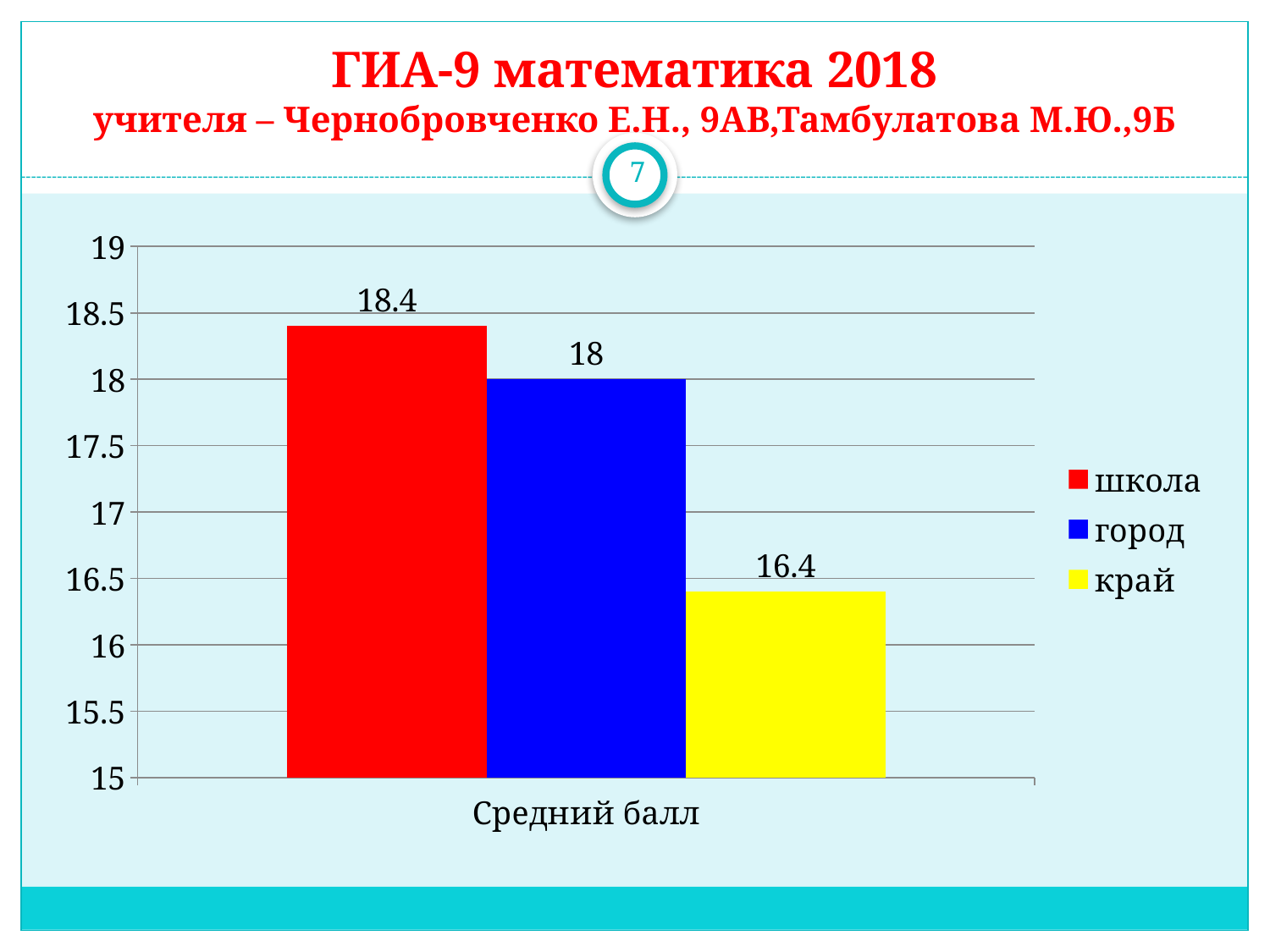
Which is larger, the value for город or the value for край? город What is the difference between the школа and город values? 0.4 What is the value for школа (school) in the Средний балл chart? 18.4 How many series does the legend list? 3 What is the difference between the школа and край values? 2 What is the value for город (city) in the Средний балл chart? 18 Which series has the highest average score? школа What is the value for край (region) in the Средний балл chart? 16.4 What kind of chart is shown on the slide? bar chart Which series has the lowest average score? край What colour is the bar for город? blue Is the value for край greater or less than 17? less